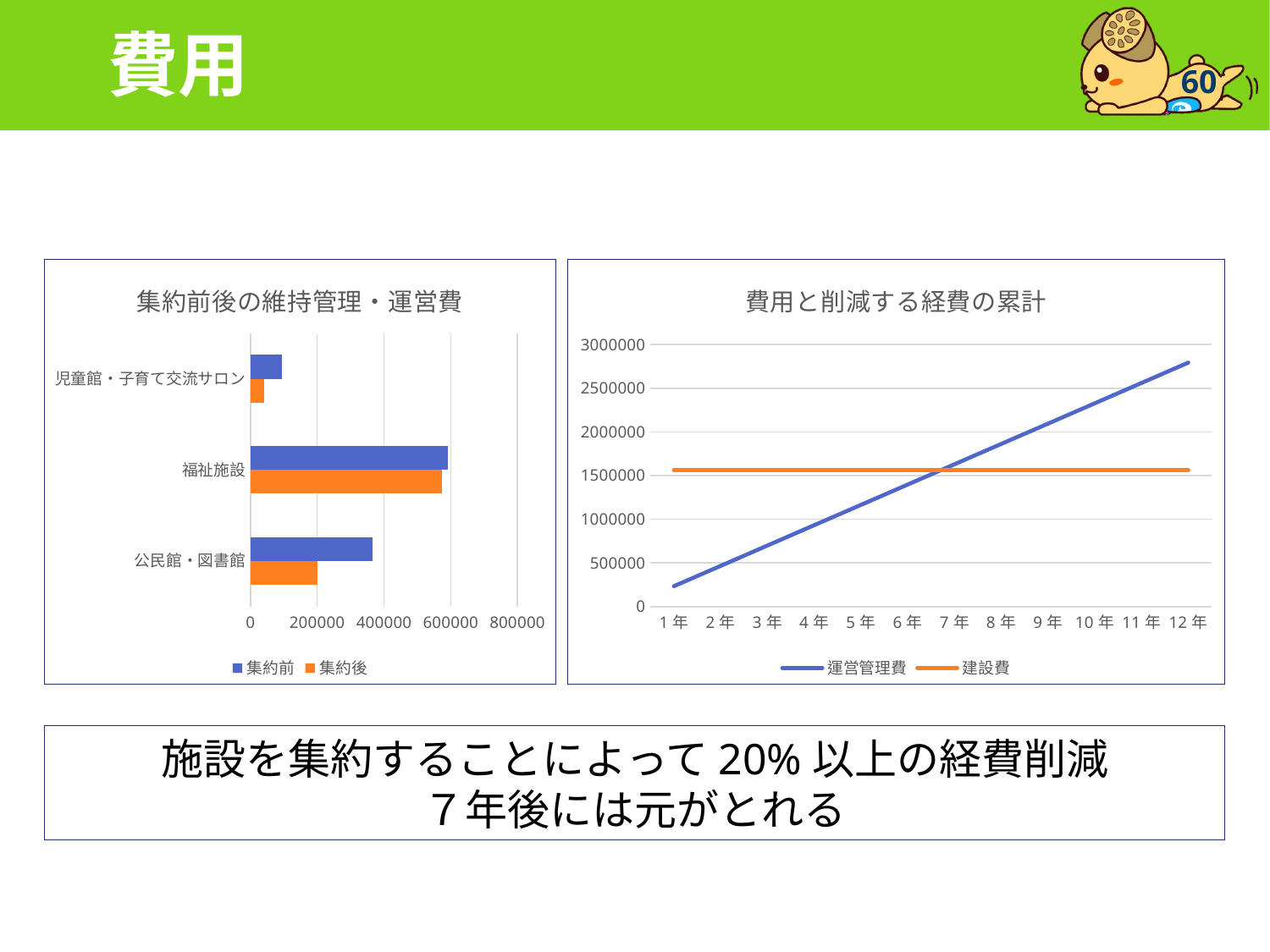
In the left chart 集約前後の維持管理・運営費, is the 集約前 value for 福祉施設 greater or less than 400000? greater In the left chart 集約前後の維持管理・運営費, how many series does the legend list? 2 In the left chart 集約前後の維持管理・運営費, which category has the highest 集約前 value? 福祉施設 In the left chart 集約前後の維持管理・運営費, for 公民館・図書館, which is larger: 集約前 or 集約後? 集約前 In the left chart 集約前後の維持管理・運営費, how many facility categories are shown? 3 What kind of chart is the left chart titled 集約前後の維持管理・運営費? bar chart In the right chart 費用と削減する経費の累計, at 3年, which is larger: 運営管理費 or 建設費? 建設費 In the left chart 集約前後の維持管理・運営費, which category has the lowest 集約後 value? 児童館・子育て交流サロン What kind of chart is the right chart titled 費用と削減する経費の累計? line chart In the right chart 費用と削減する経費の累計, does the 運営管理費 line rise or fall from 1年 to 12年? rise In the right chart 費用と削減する経費の累計, how many years are shown on the x axis? 12 In the right chart 費用と削減する経費の累計, is the 運営管理費 value at 12年 greater or less than 2500000? greater